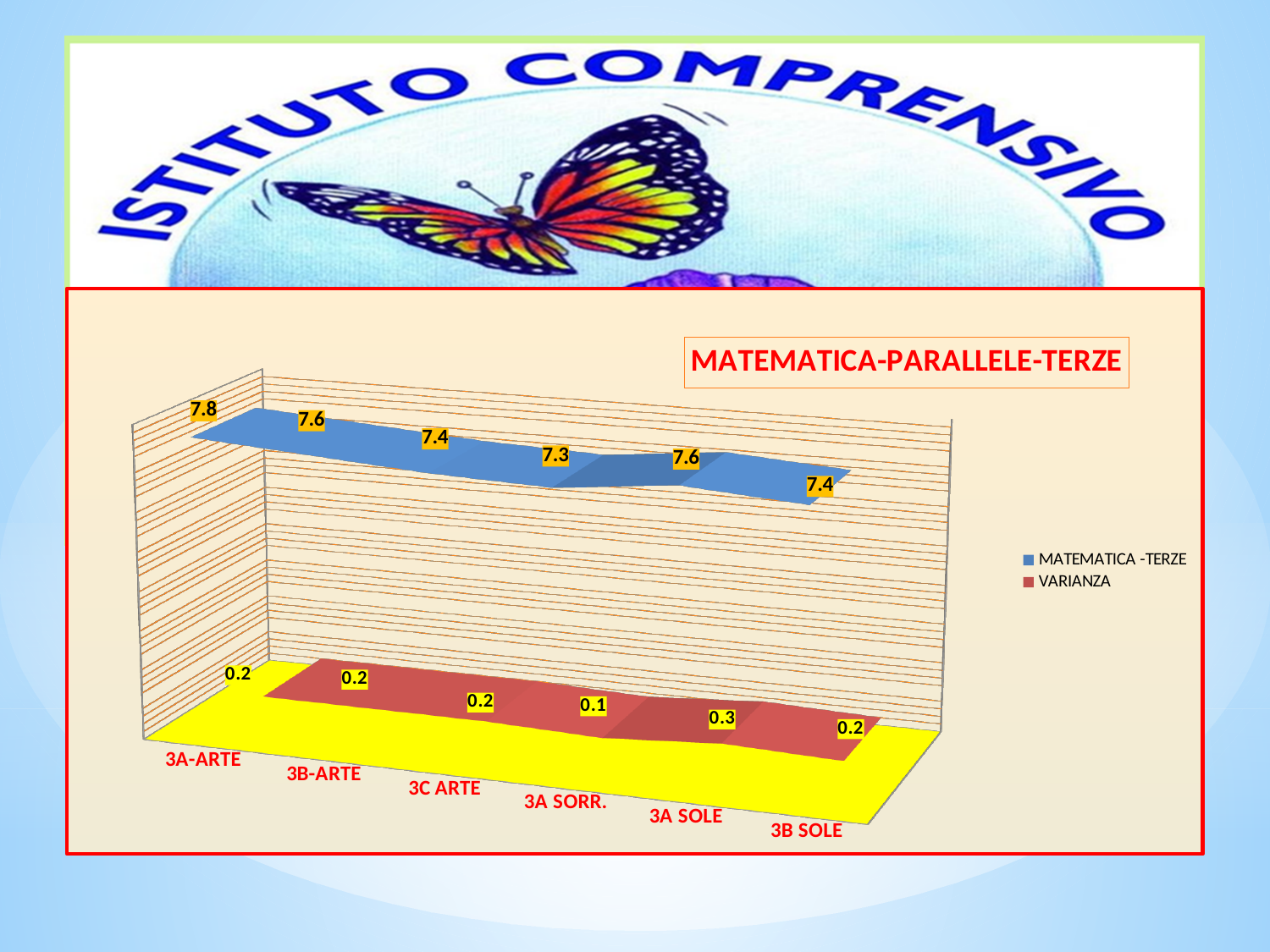
What is the VARIANZA value for 3A SORR.? 0.1 How many series does the legend list? 2 What is the title of the chart? MATEMATICA-PARALLELE-TERZE Which category has the lowest MATEMATICA -TERZE value? 3A SORR. How many categories are shown on the chart? 6 Which category has the highest MATEMATICA -TERZE value? 3A-ARTE Which has a higher MATEMATICA -TERZE value, 3B-ARTE or 3B SOLE? 3B-ARTE Which category has the highest VARIANZA value? 3A SOLE What is the MATEMATICA -TERZE value for 3A SORR.? 7.3 What is the difference between the MATEMATICA -TERZE values for 3A-ARTE and 3A SORR.? 0.5 What is the MATEMATICA -TERZE value for 3A-ARTE? 7.8 What is the VARIANZA value for 3A SOLE? 0.3